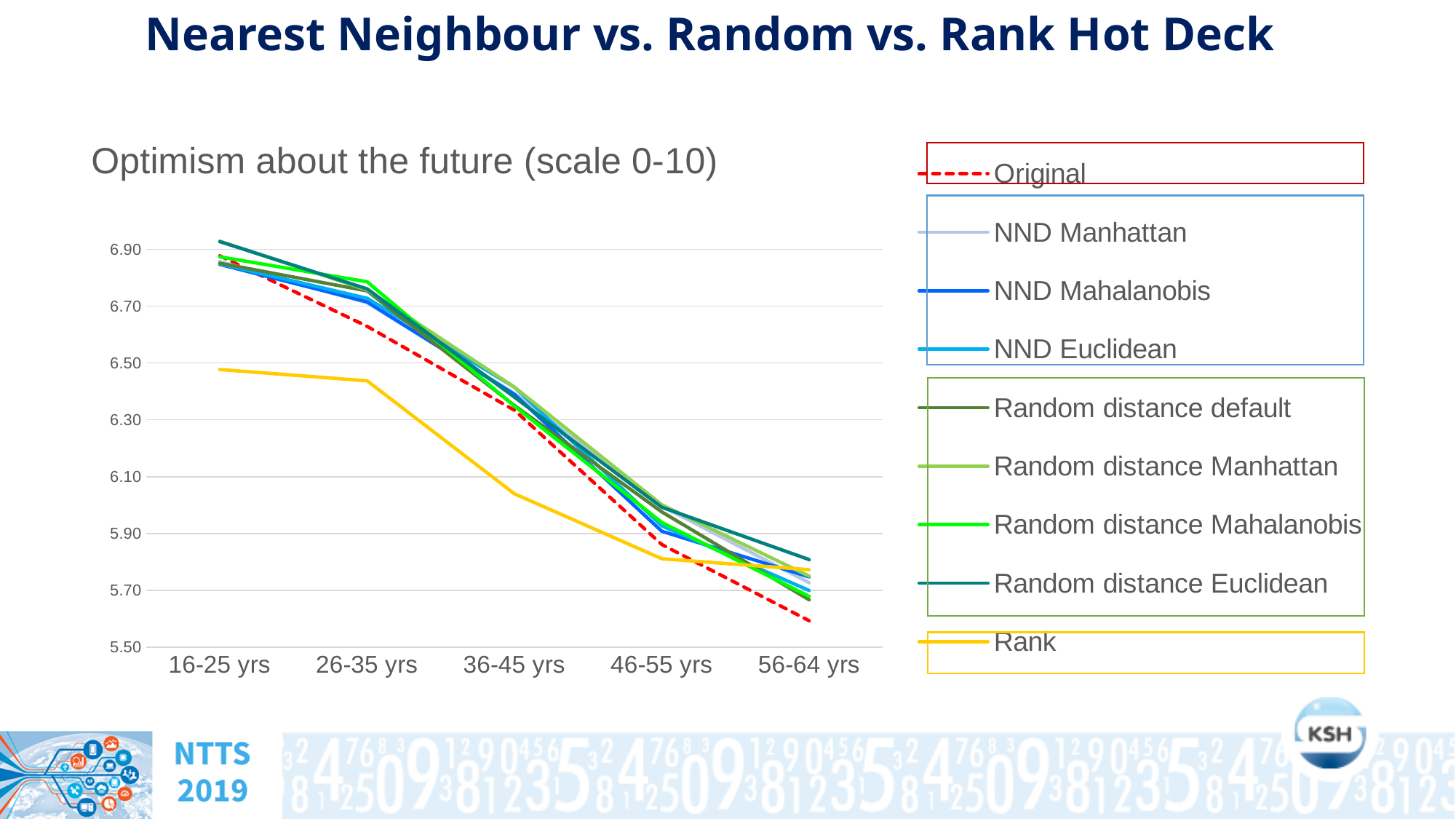
What is the title of the chart? Optimism about the future (scale 0-10) For the 56-64 yrs group, which is larger: the Rank series or the Original series? Rank What kind of chart is shown on the slide? line chart For the 16-25 yrs group, which is larger: the Original series or the Rank series? Original Is the value of the Original series for 56-64 yrs greater or less than 5.70? less Which series has the lowest value for the 56-64 yrs group? Original How many age-group categories are shown on the x axis? 5 How many series does the legend list? 9 Is the value of the Rank series for 36-45 yrs greater or less than 6.10? less Does the Original series rise or fall as age group increases along the x axis? fall Is the value of the Original series for 16-25 yrs greater or less than 6.70? greater Which series has the lowest value for the 16-25 yrs group? Rank